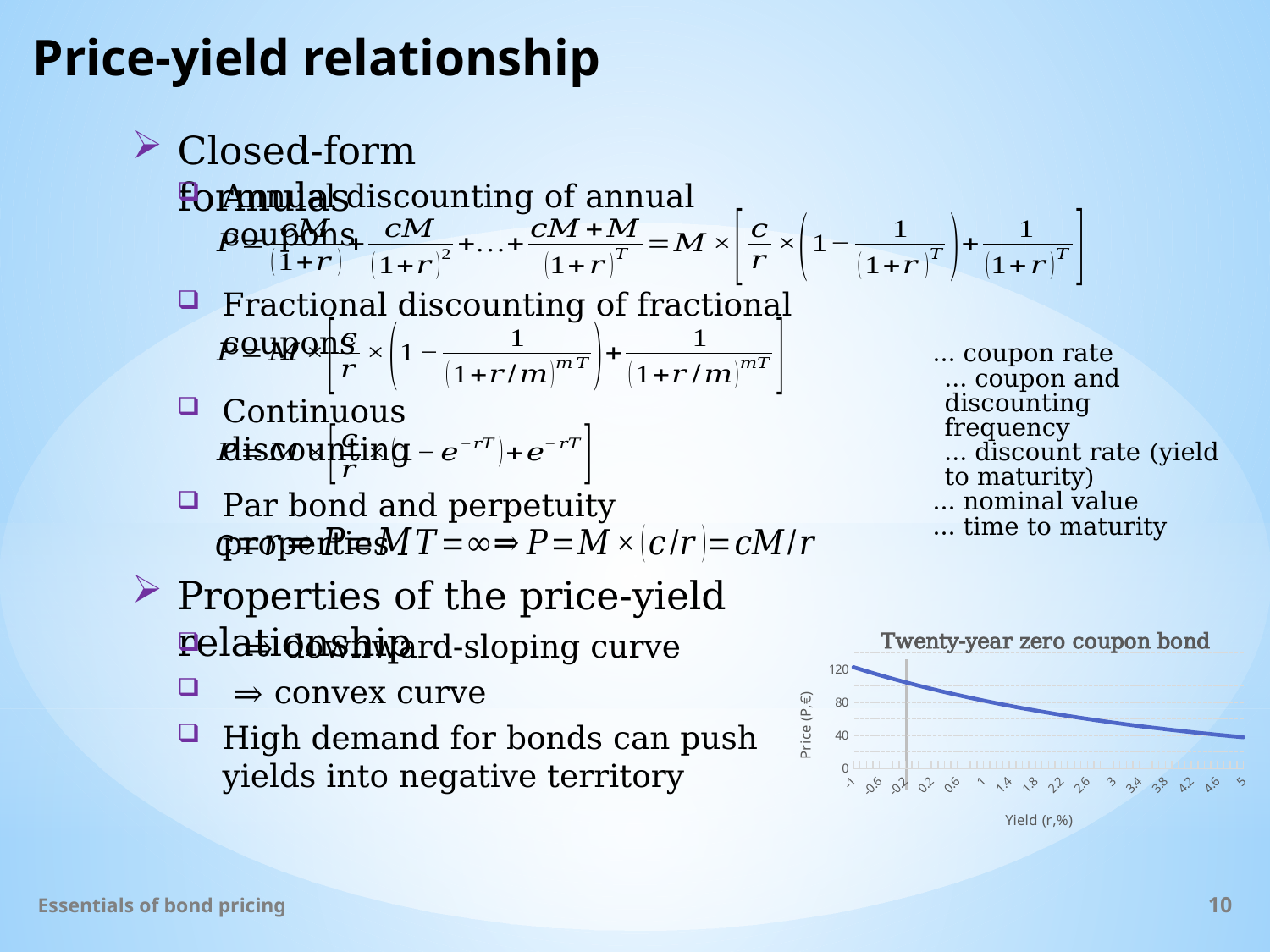
Is the price at a yield of 5 greater or less than 80? less What kind of chart is shown on the slide? line chart What is the highest tick value shown on the price axis of the chart? 120 Is the price at a yield of 3 greater or less than 40? greater Does the price rise or fall as the yield increases along the x axis? fall What is the title of the chart on the slide? Twenty-year zero coupon bond Is the price at a yield of -0.6 greater or less than 80? greater What is the label of the vertical axis of the chart? Price (P,€) How many tick labels are shown on the yield (x) axis of the chart? 16